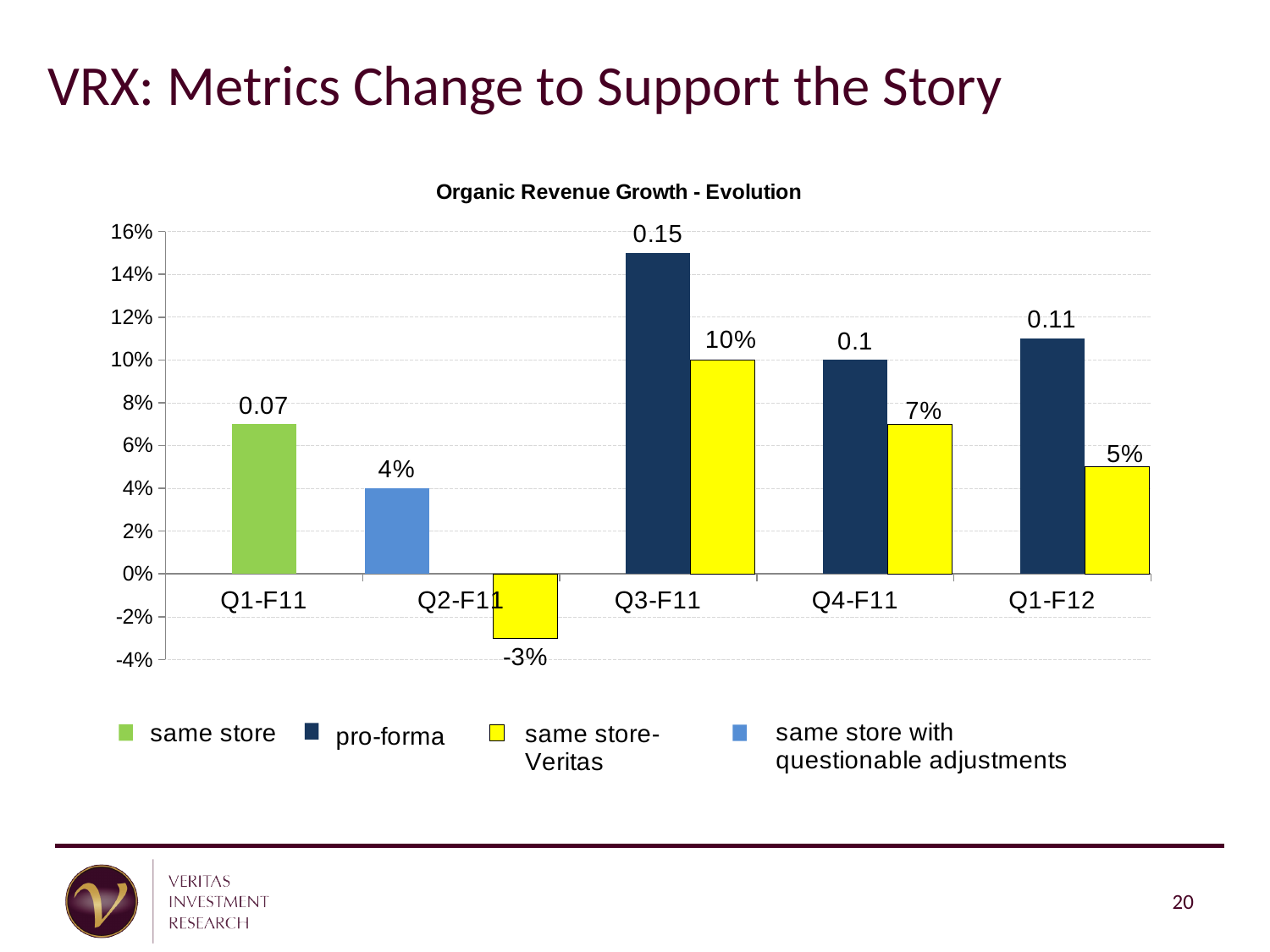
How many series does the legend list? 4 What is the title of the chart? Organic Revenue Growth - Evolution What is the same store value for Q1-F11? 0.07 What type of chart is shown on the slide? bar chart What is the difference between the same store-Veritas values for Q3-F11 and Q4-F11? 3% Which quarter has the lowest same store-Veritas value? Q2-F11 What is the same store-Veritas value for Q2-F11? -3% What is the pro-forma value for Q3-F11? 0.15 Which quarter has the highest pro-forma value? Q3-F11 Do the same store-Veritas values rise or fall from Q3-F11 to Q1-F12? fall What is the same store-Veritas value for Q1-F12? 5% How many quarters are shown on the x axis? 5